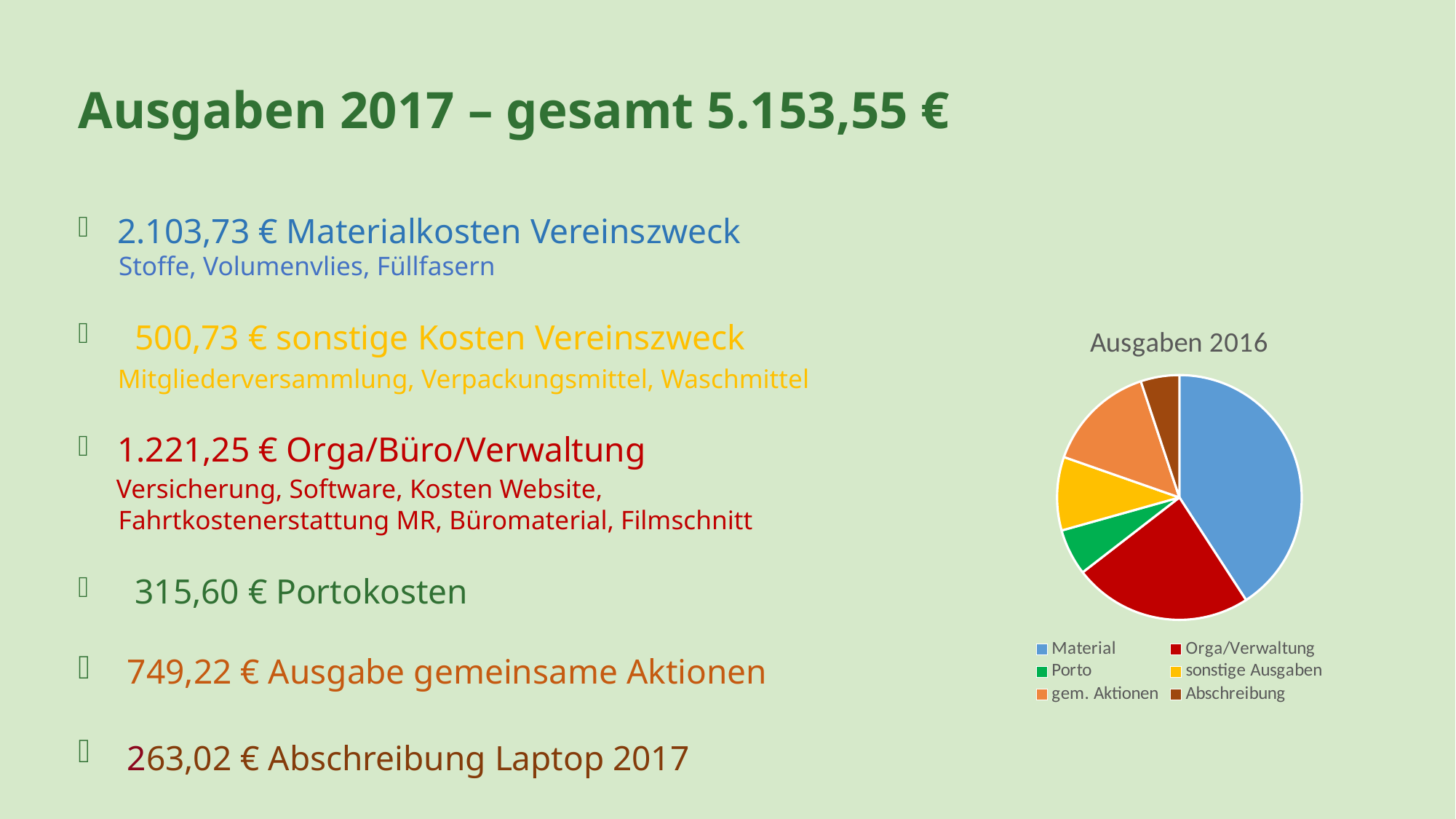
How many slices does the pie chart have? 6 In the pie chart, which slice is larger: gem. Aktionen or Porto? gem. Aktionen What is the title of the pie chart? Ausgaben 2016 In the pie chart, which slice is larger: Orga/Verwaltung or Porto? Orga/Verwaltung How many entries does the legend of the pie chart list? 6 In the pie chart, which slice is larger: gem. Aktionen or Orga/Verwaltung? Orga/Verwaltung Which category has the largest slice in the pie chart? Material What kind of chart is shown on the slide? pie chart What colour is the Material slice in the pie chart? blue